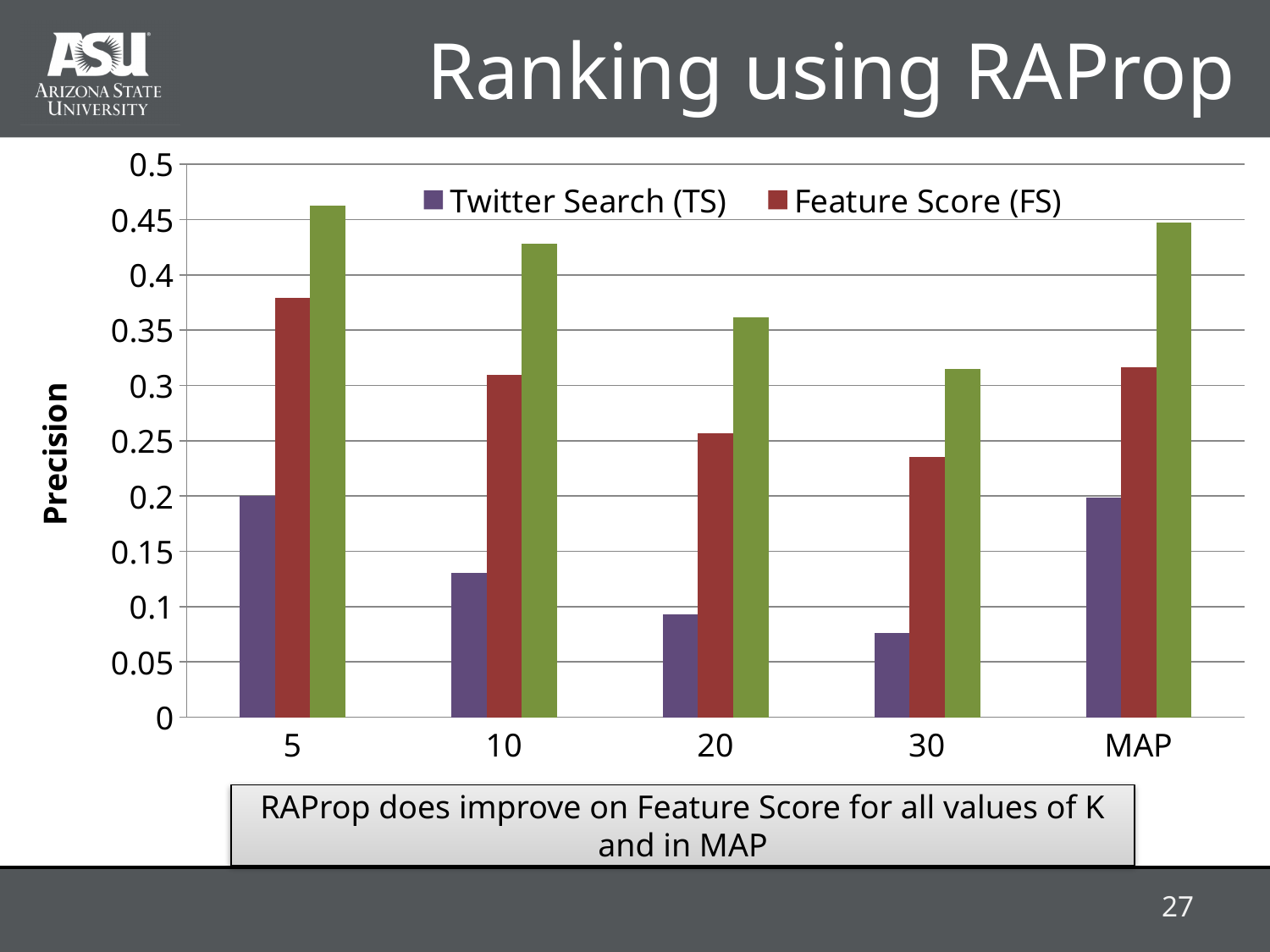
What is the title of the slide containing the chart? Ranking using RAProp Do the Twitter Search (TS) values rise or fall from 5 to 30 along the x axis? fall Is the Twitter Search (TS) value at 5 greater or less than 0.15? greater Is the Feature Score (FS) value at 5 greater or less than 0.35? greater Which category has the highest Feature Score (FS) value? 5 What kind of chart is shown on the slide? bar chart Which category has the lowest Feature Score (FS) value? 30 How many categories are shown on the x axis? 5 Is the Twitter Search (TS) value at 30 greater or less than 0.1? less What is the label of the y axis? Precision How many series does the legend list? 2